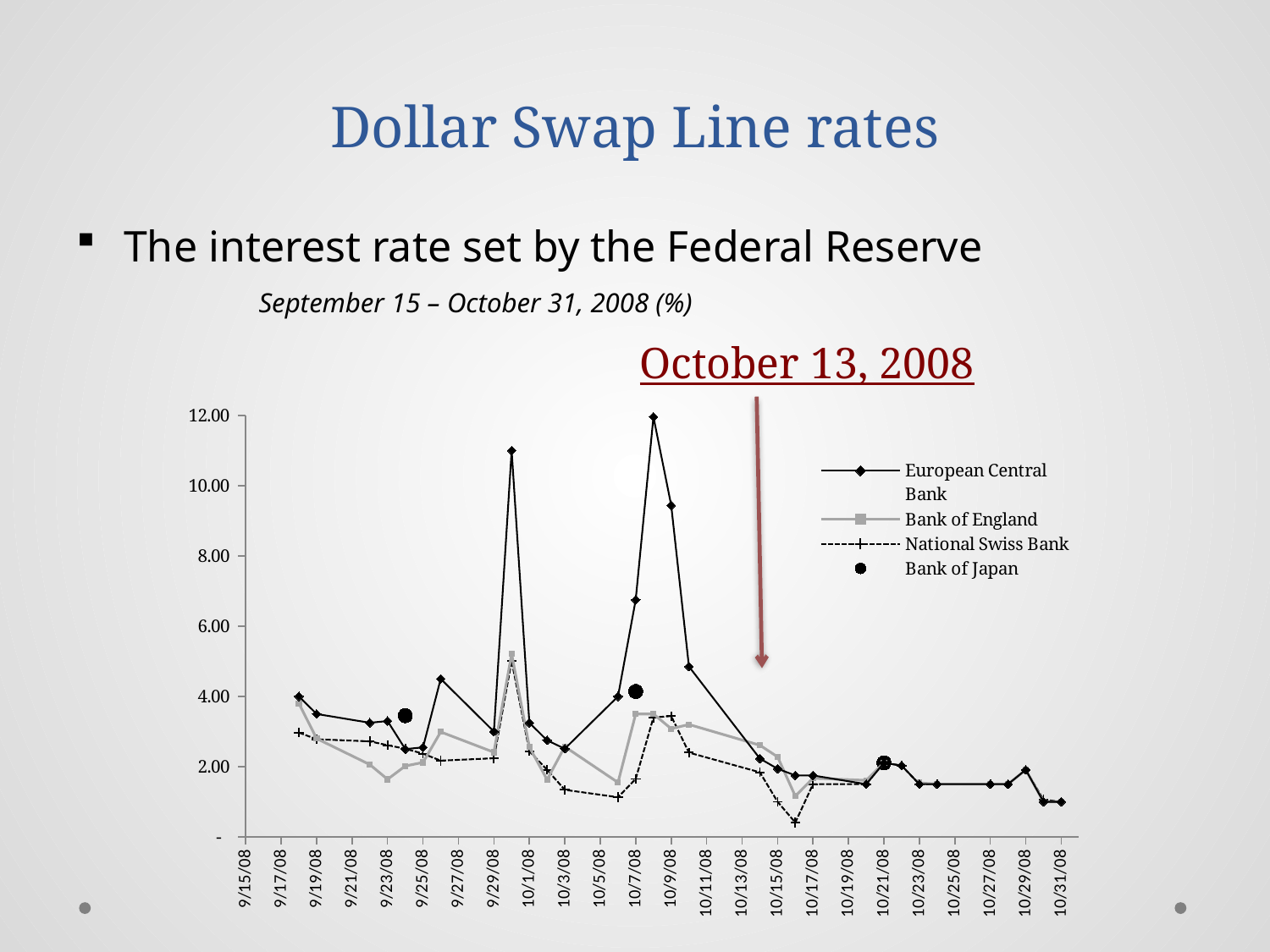
How many series does the chart legend list? 4 On 9/30/08, which is larger: the European Central Bank value or the Bank of England value? European Central Bank What date is annotated with the red arrow above the chart? October 13, 2008 Which series is shown in the legend as a single dot marker rather than a line? Bank of Japan Does the European Central Bank series generally rise or fall from 10/9/08 to 10/31/08? fall Is the European Central Bank value on 9/30/08 greater or less than 10.00? greater Is the Bank of England value on 9/30/08 greater or less than 4.00? greater Which series reaches the lowest value on the chart? National Swiss Bank Which series reaches the highest value on the chart? European Central Bank Is the European Central Bank value on 10/9/08 greater or less than 8.00? greater What kind of chart is shown on the slide? line chart